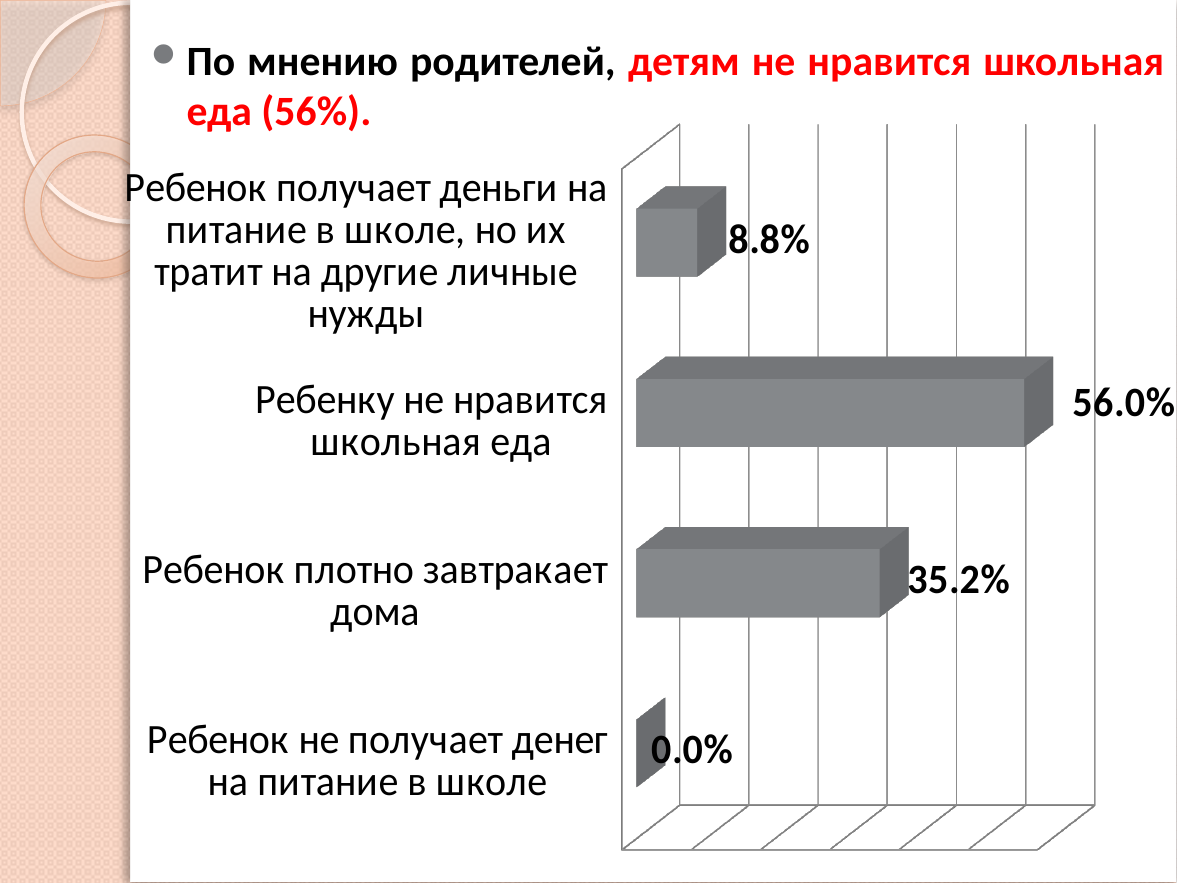
Which category has the highest value? Ребенку не нравится школьная еда What is the value for "Ребенку не нравится школьная еда"? 56.0% What kind of chart is shown on the slide? Bar chart What is the value for "Ребенок не получает денег на питание в школе"? 0.0% Which is larger: the value for "Ребенок плотно завтракает дома" or the value for "Ребенок получает деньги на питание в школе, но их тратит на другие личные нужды"? Ребенок плотно завтракает дома What is the difference between the values for "Ребенку не нравится школьная еда" and "Ребенок плотно завтракает дома"? 20.8% Which category has the lowest value? Ребенок не получает денег на питание в школе What is the difference between the values for "Ребенок плотно завтракает дома" and "Ребенок получает деньги на питание в школе, но их тратит на другие личные нужды"? 26.4% What is the value for "Ребенок получает деньги на питание в школе, но их тратит на другие личные нужды"? 8.8% How many categories are shown in the chart? 4 What is the value for "Ребенок плотно завтракает дома"? 35.2% What colour are the bars in the chart? Grey